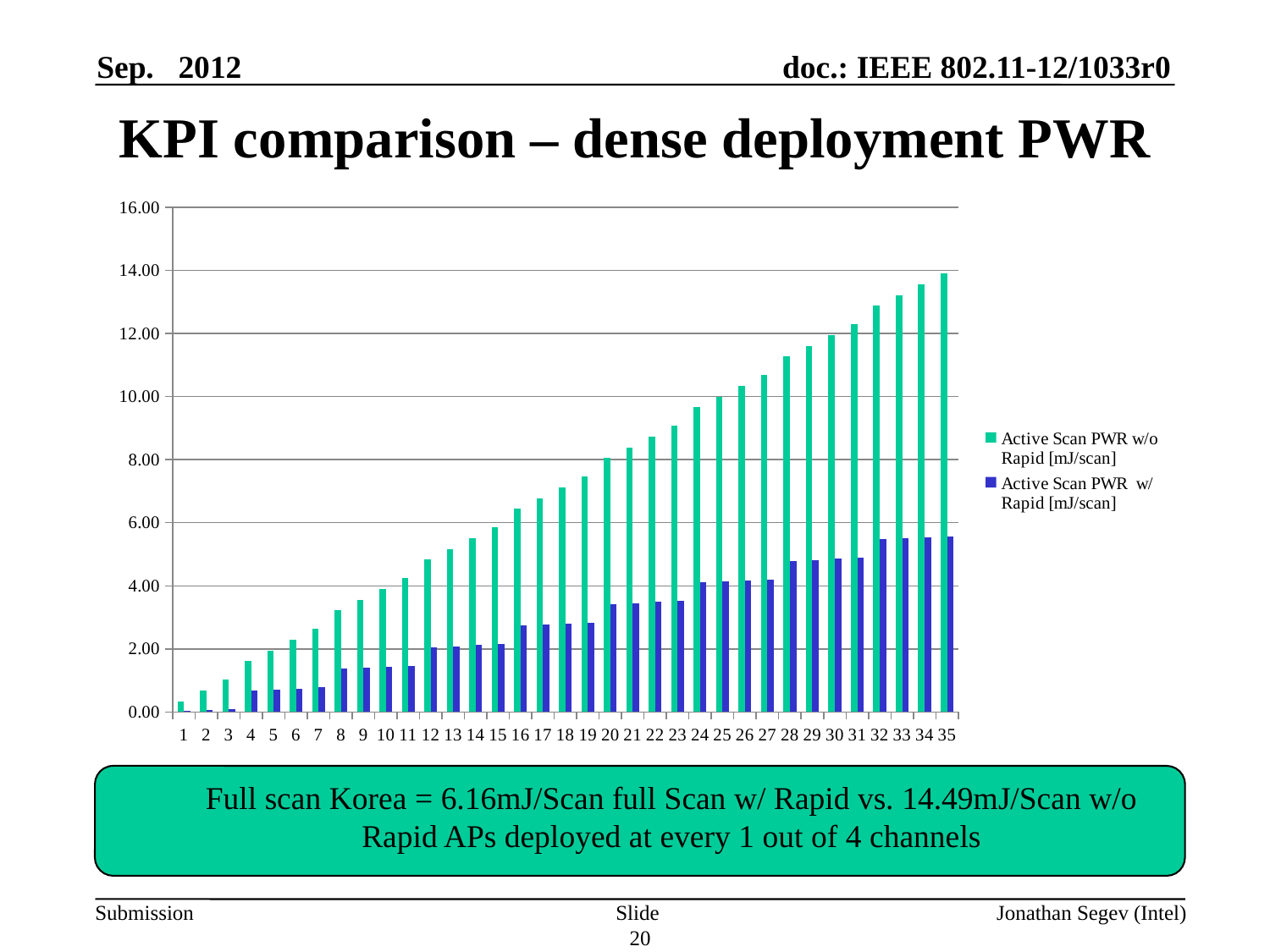
At category 35, which series has the larger value: Active Scan PWR w/o Rapid or Active Scan PWR w/ Rapid? Active Scan PWR w/o Rapid How many series does the legend list? 2 How many categories are shown along the x axis? 35 Is the value for Active Scan PWR w/ Rapid at category 35 greater or less than 4.00? greater Do the values for Active Scan PWR w/o Rapid rise or fall as the category number increases from 1 to 35? rise Which category has the highest value for Active Scan PWR w/o Rapid [mJ/scan]? 35 What kind of chart is shown on the slide? bar chart What is the title of the slide containing the chart? KPI comparison – dense deployment PWR Which category has the lowest value for Active Scan PWR w/ Rapid [mJ/scan]? 1 Is the value for Active Scan PWR w/o Rapid at category 28 greater or less than 10.00? greater Is the value for Active Scan PWR w/ Rapid at category 20 greater or less than 4.00? less